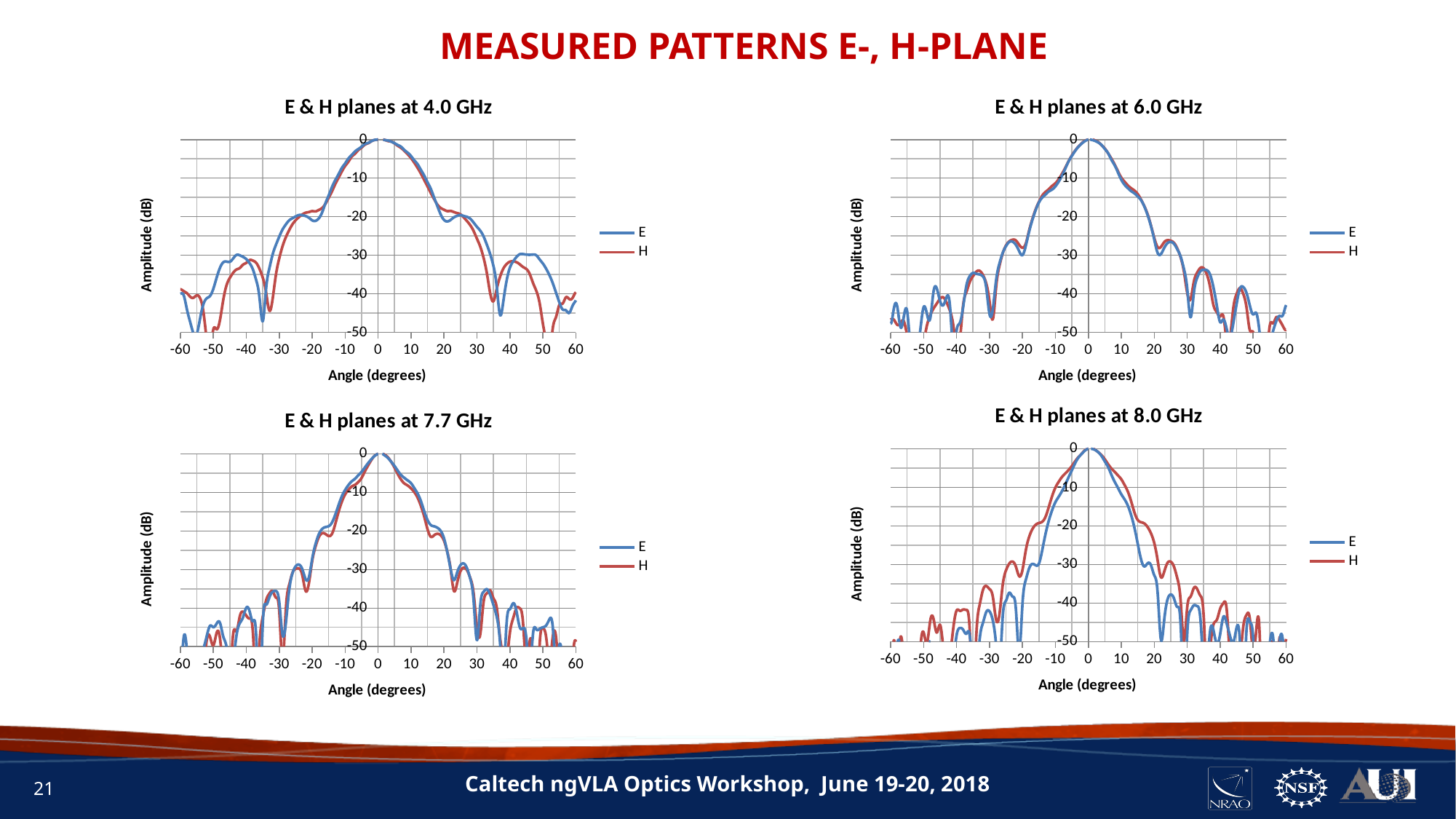
In 'E & H planes at 8.0 GHz', what is the amplitude of the H series at 0 degrees? 0 In 'E & H planes at 6.0 GHz', is the H value at 20 degrees greater or less than -10? less What are the legend entries in the 'E & H planes at 7.7 GHz' chart? E and H How many series does the legend of 'E & H planes at 6.0 GHz' list? 2 In 'E & H planes at 7.7 GHz', is the E value at 30 degrees greater or less than -20? less In 'E & H planes at 4.0 GHz', what is the amplitude of the E series at 0 degrees? 0 How many charts are shown on the slide? 4 What is the y-axis label on the 'E & H planes at 6.0 GHz' chart? Amplitude (dB) In 'E & H planes at 8.0 GHz', is the H value at 10 degrees greater or less than -20? greater What kind of chart is 'E & H planes at 4.0 GHz'? line chart In 'E & H planes at 8.0 GHz', which series has the larger amplitude at -20 degrees, E or H? H